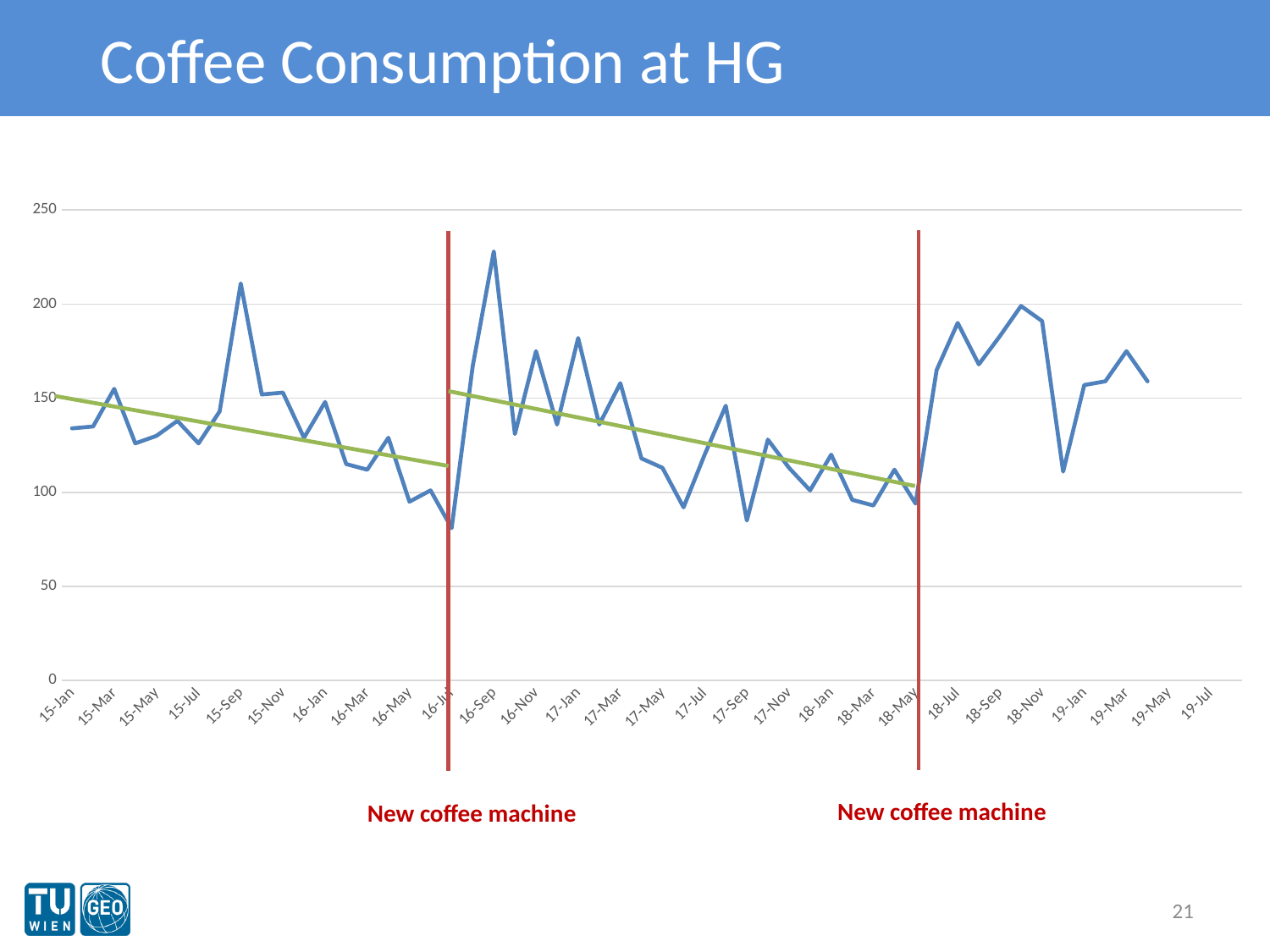
Do the green trend lines rise or fall from left to right? fall Is the value at 15-Sep greater or less than 200? greater Is the value at 16-Sep greater or less than 200? greater What do the two red vertical lines on the chart mark? New coffee machine Is the value at 17-Sep greater or less than 100? less Around which x-axis label does the line reach its highest point? 16-Sep What kind of chart is shown on the slide? line chart What is the highest value shown on the y axis? 250 What is the title of the chart? Coffee Consumption at HG